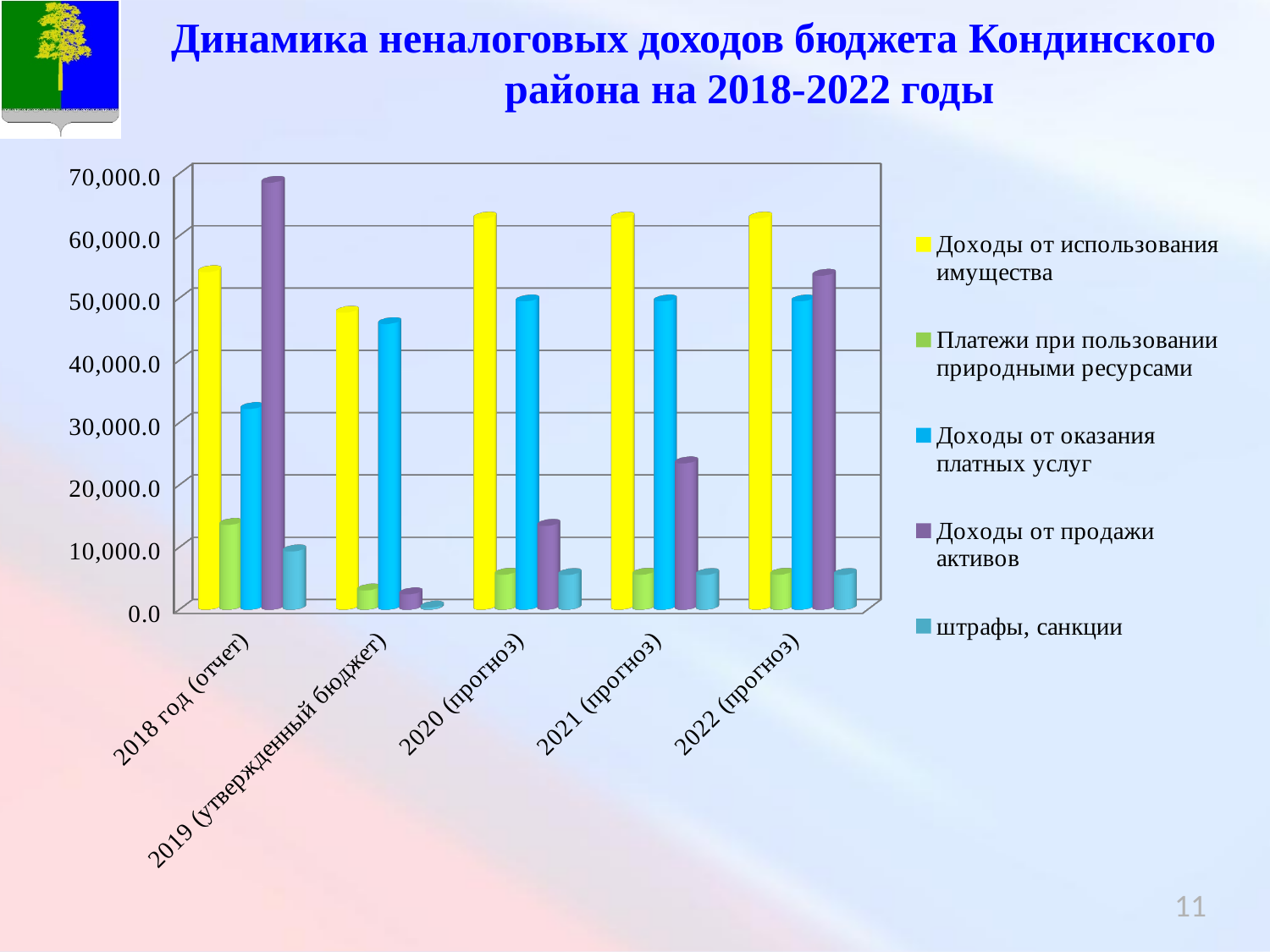
Which category has the highest value for Доходы от продажи активов? 2018 год (отчет) Is the value for Доходы от продажи активов in 2021 (прогноз) greater or less than 20,000.0? greater How many categories are shown on the x axis of the chart? 5 Does the value for Доходы от продажи активов rise or fall from 2020 (прогноз) to 2022 (прогноз)? rise Is the value for Доходы от продажи активов in 2018 год (отчет) greater or less than 60,000.0? greater Which category has the lowest value for Доходы от продажи активов? 2019 (утвержденный бюджет) In 2022 (прогноз), which is larger: Доходы от использования имущества or Доходы от продажи активов? Доходы от использования имущества How many series does the chart legend list? 5 What kind of chart is shown on the slide? bar chart Is the value for Доходы от использования имущества in 2019 (утвержденный бюджет) greater or less than 50,000.0? less In 2018 год (отчет), which is larger: Доходы от использования имущества or Доходы от продажи активов? Доходы от продажи активов Which category has the lowest value for Доходы от использования имущества? 2019 (утвержденный бюджет)